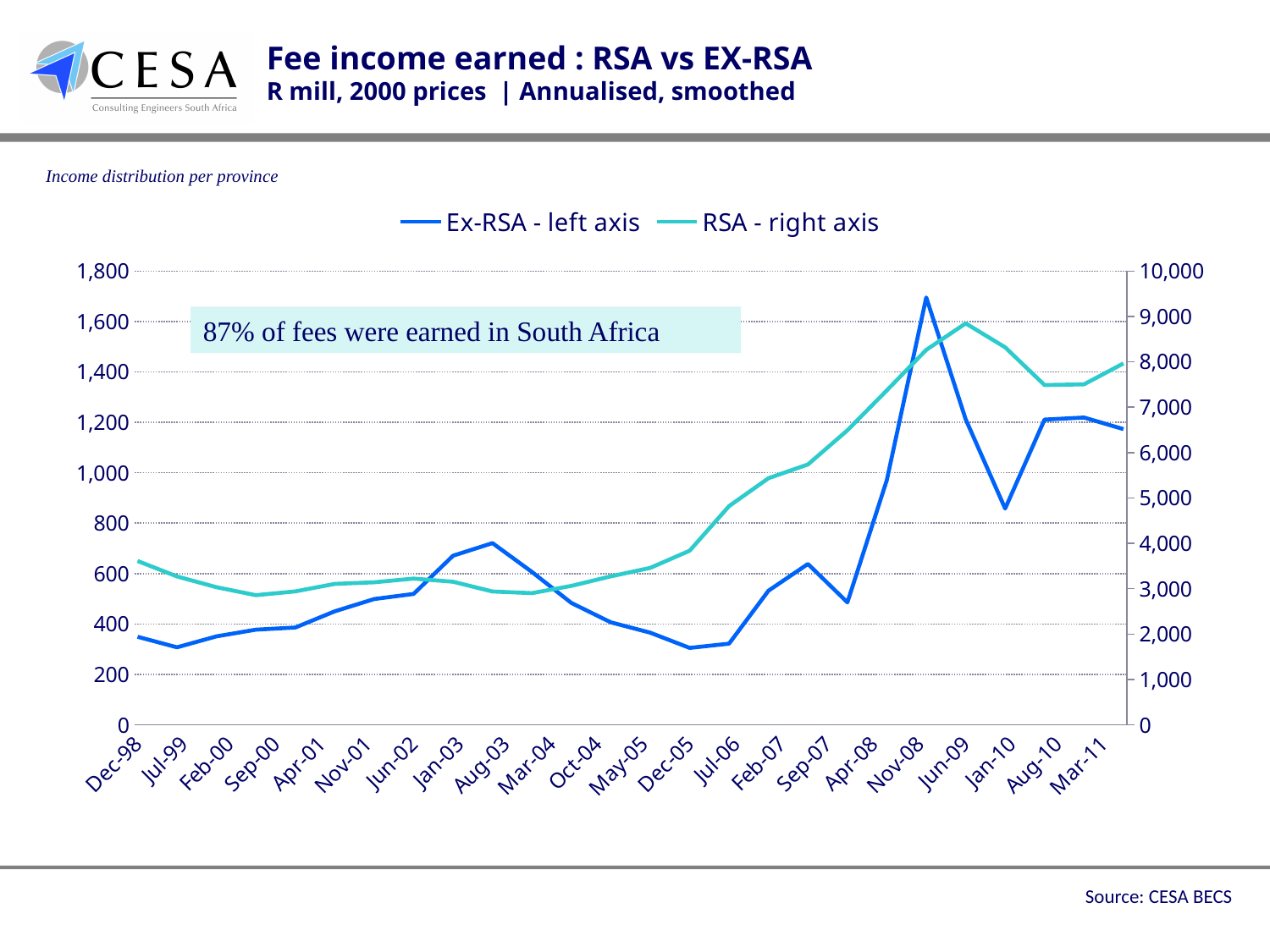
At which x-axis label does the RSA series reach its highest value? Jun-09 How many labels are shown on the x axis? 22 What percentage of fees does the annotation on the chart say were earned in South Africa? 87% Is the Ex-RSA value at Jan-10 greater or less than 1,000? less Which series is plotted against the right axis? RSA Is the RSA value at Jun-09 greater or less than 8,000? greater What kind of chart is shown on the slide? Line chart Is the Ex-RSA value at Dec-05 greater or less than 400? less Does the RSA series rise or fall between Dec-05 and Jun-09? rise At which x-axis label does the Ex-RSA series reach its highest value? Nov-08 How many series does the legend list? 2